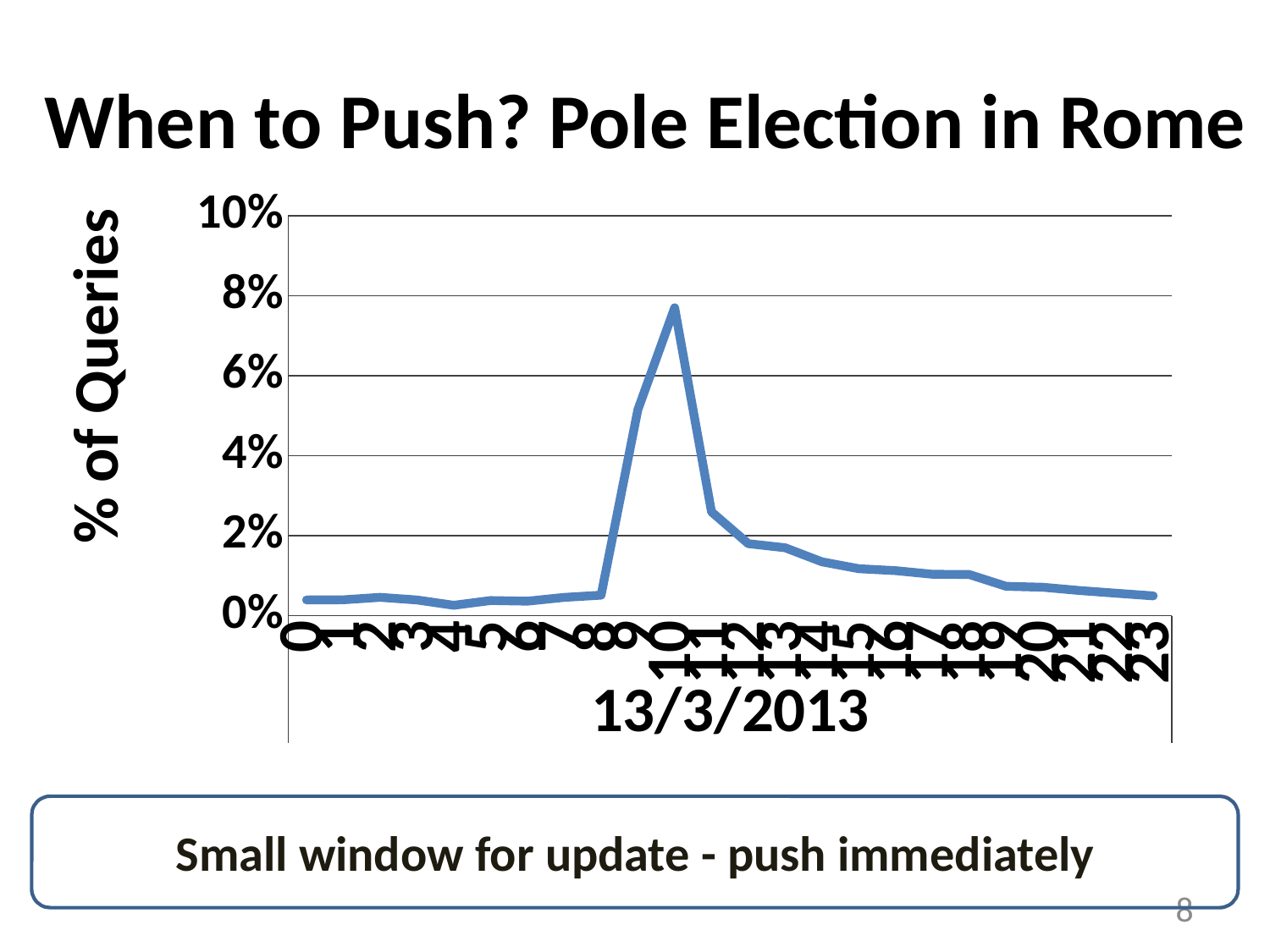
Which is larger: the value at the peak of the line or the value at the first point on the left? the peak What is the label on the vertical axis of the chart? % of Queries What date is printed below the x axis of the chart? 13/3/2013 Is the value at the first point on the left of the line greater or less than 2%? less What is the highest value shown on the vertical axis of the chart? 10% Is the value at the last point on the right of the line greater or less than 2%? less What kind of chart is shown on the slide? line chart Is the peak value of the line greater or less than 8%? less After reaching its peak, does the line rise or fall as it moves to the right along the x axis? fall